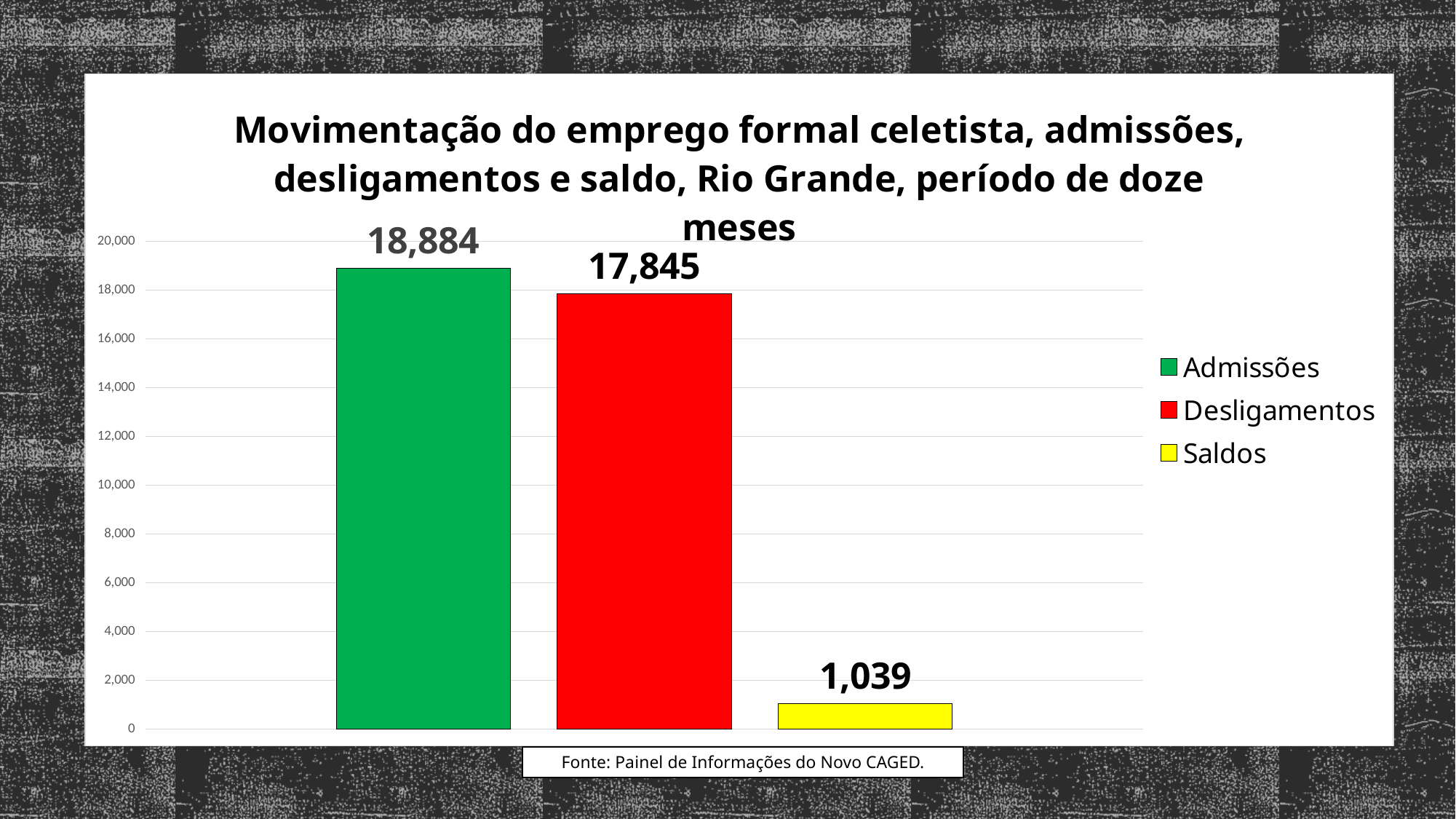
Is the value for Saldos greater or less than 2,000? less What is the value for Admissões? 18,884 How many series does the legend list? 3 What colour is the bar for Saldos? Yellow Is the value for Desligamentos greater or less than 16,000? greater Which series has the lowest value? Saldos Which is larger, Desligamentos or Saldos? Desligamentos What is the difference between Admissões and Desligamentos? 1,039 What is the value for Saldos? 1,039 Which series has the highest value? Admissões What kind of chart is shown? Bar chart What is the value for Desligamentos? 17,845